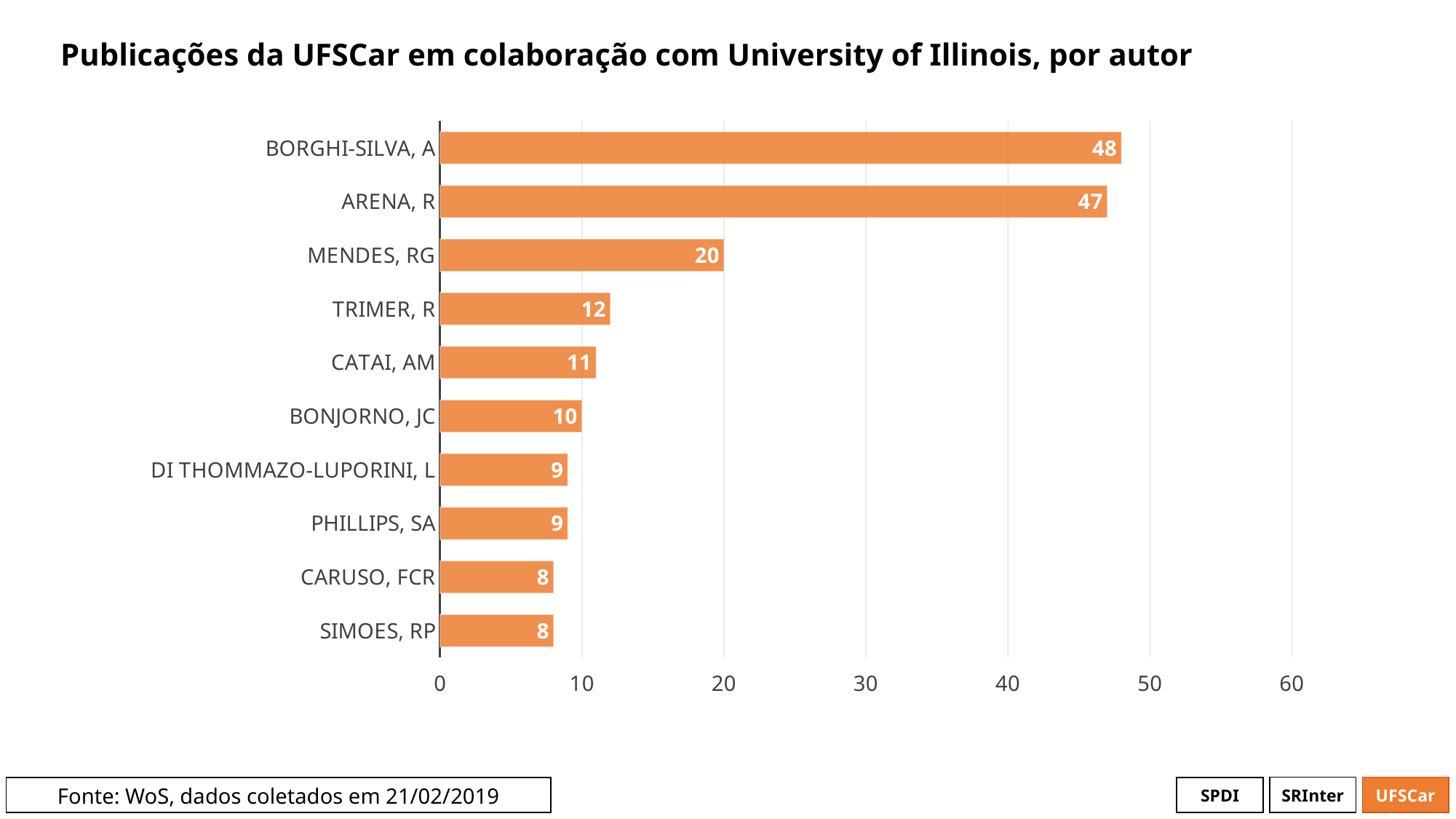
Which author has the highest number of publications? BORGHI-SILVA, A How many authors are shown in the chart? 10 Which has a larger value, TRIMER, R or BONJORNO, JC? TRIMER, R Is the value for ARENA, R greater or less than 40? greater Which has a larger value, ARENA, R or MENDES, RG? ARENA, R What kind of chart is shown on the slide? bar chart What is the difference between the values for MENDES, RG and TRIMER, R? 8 What is the value shown for MENDES, RG? 20 What is the value shown for CATAI, AM? 11 What is the difference between the values for BORGHI-SILVA, A and ARENA, R? 1 How many publications does BORGHI-SILVA, A have? 48 What is the title of the chart? Publicações da UFSCar em colaboração com University of Illinois, por autor